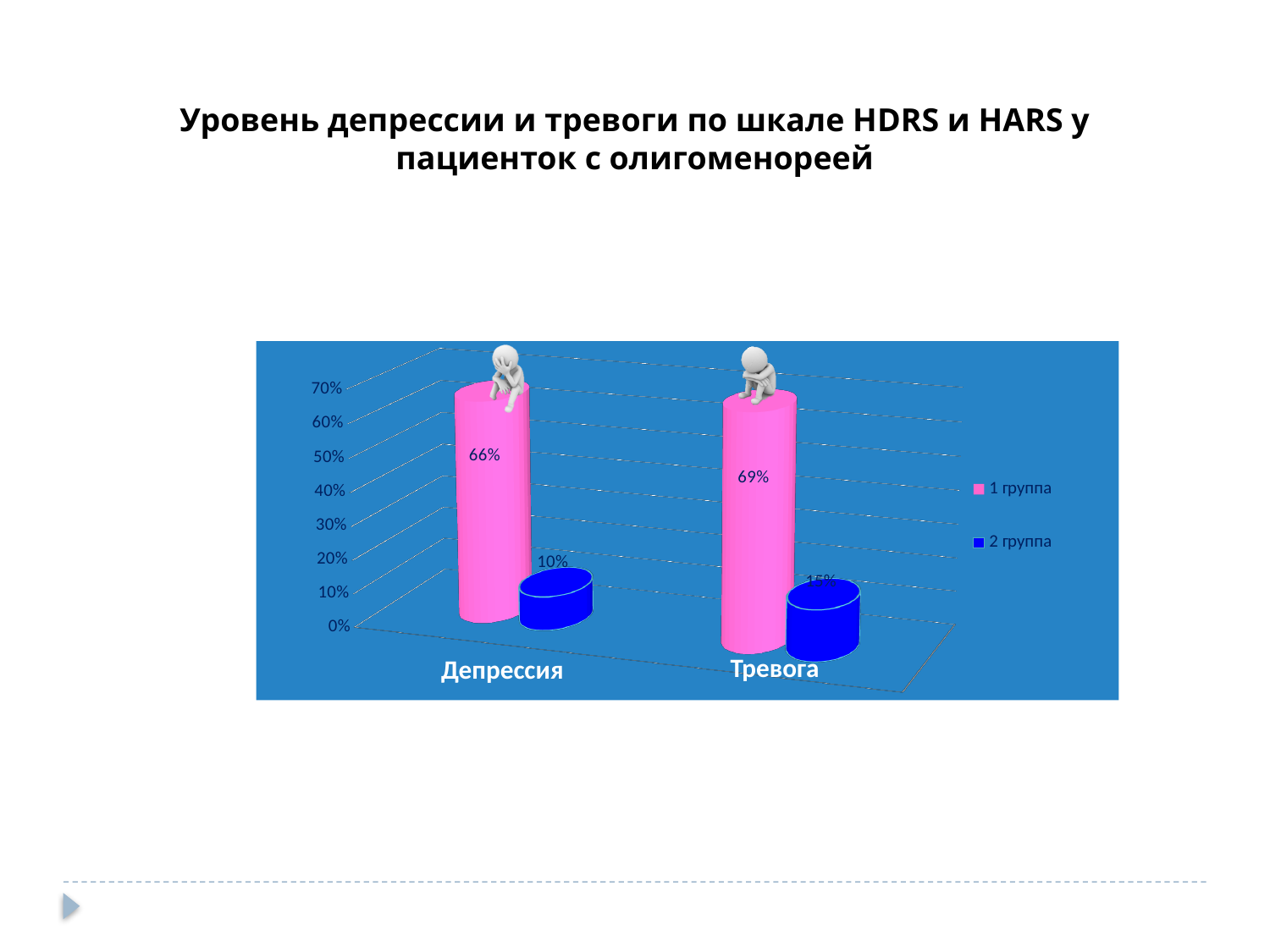
What is the value for 1 группа in the Тревога category? 69% What is the value for 2 группа in the Депрессия category? 10% What kind of chart is shown on the slide? bar chart Which category has the lower value for 2 группа? Депрессия Is the value for 2 группа in the Тревога category greater or less than 20%? less Which category has the higher value for 1 группа? Тревога What is the value for 1 группа in the Депрессия category? 66% In the Тревога category, which series has the larger value, 1 группа or 2 группа? 1 группа How many categories are shown on the x axis? 2 What is the difference between the 1 группа and 2 группа values in the Депрессия category? 56% How many series does the legend list? 2 What is the difference between the 1 группа values for Тревога and Депрессия? 3%